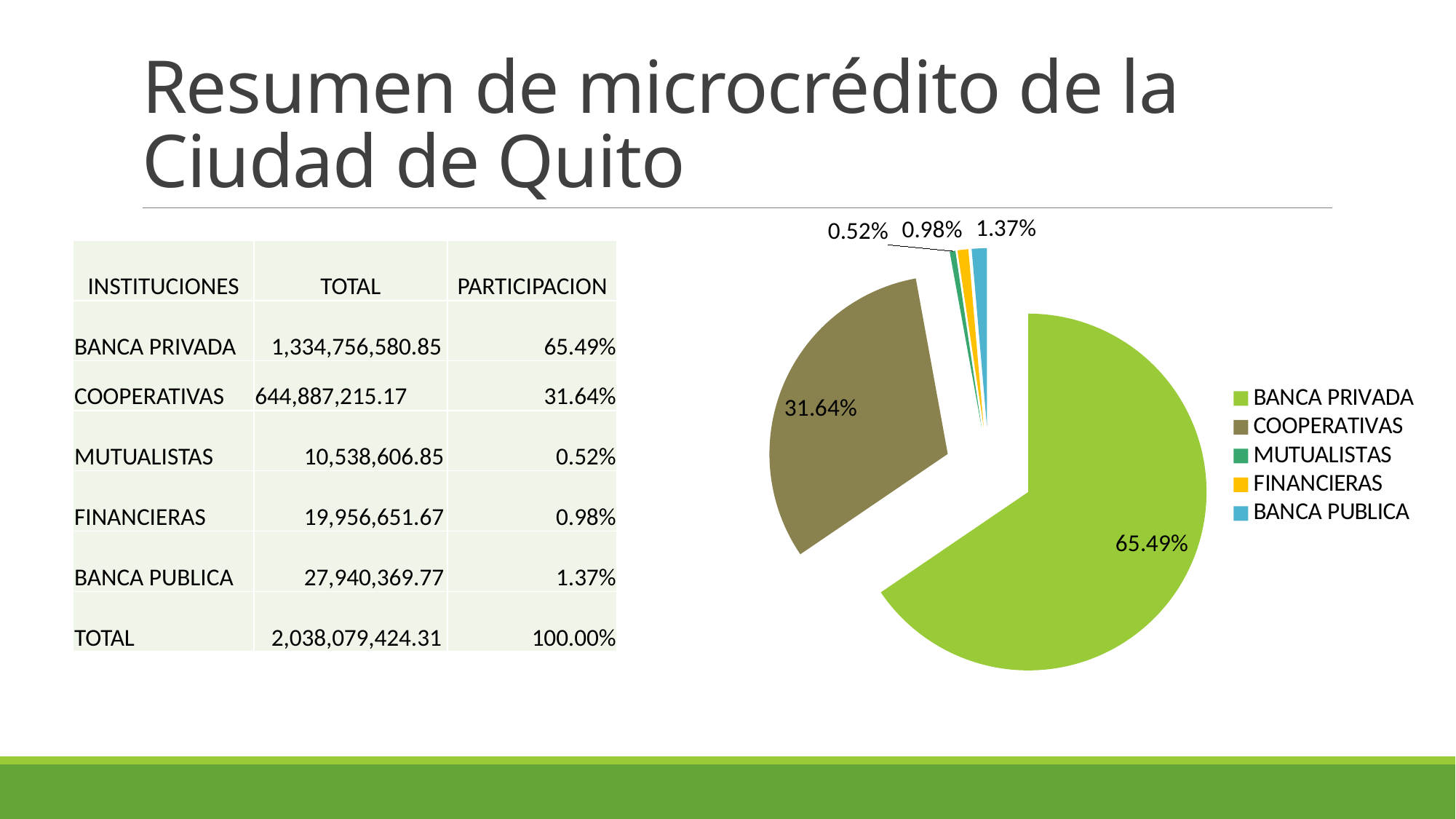
Which category has the smallest slice of the pie? MUTUALISTAS What share of the pie does MUTUALISTAS hold? 0.52% Which is larger, the share for FINANCIERAS or the share for BANCA PUBLICA? BANCA PUBLICA What colour is the COOPERATIVAS slice in the pie chart? olive brown What share of the pie does BANCA PUBLICA hold? 1.37% What kind of chart is shown on the slide? pie chart What share of the pie does COOPERATIVAS hold? 31.64% How many slices does the pie chart have? 5 What is the difference in percentage points between the BANCA PRIVADA share and the COOPERATIVAS share? 33.85 Which category has the largest slice of the pie? BANCA PRIVADA